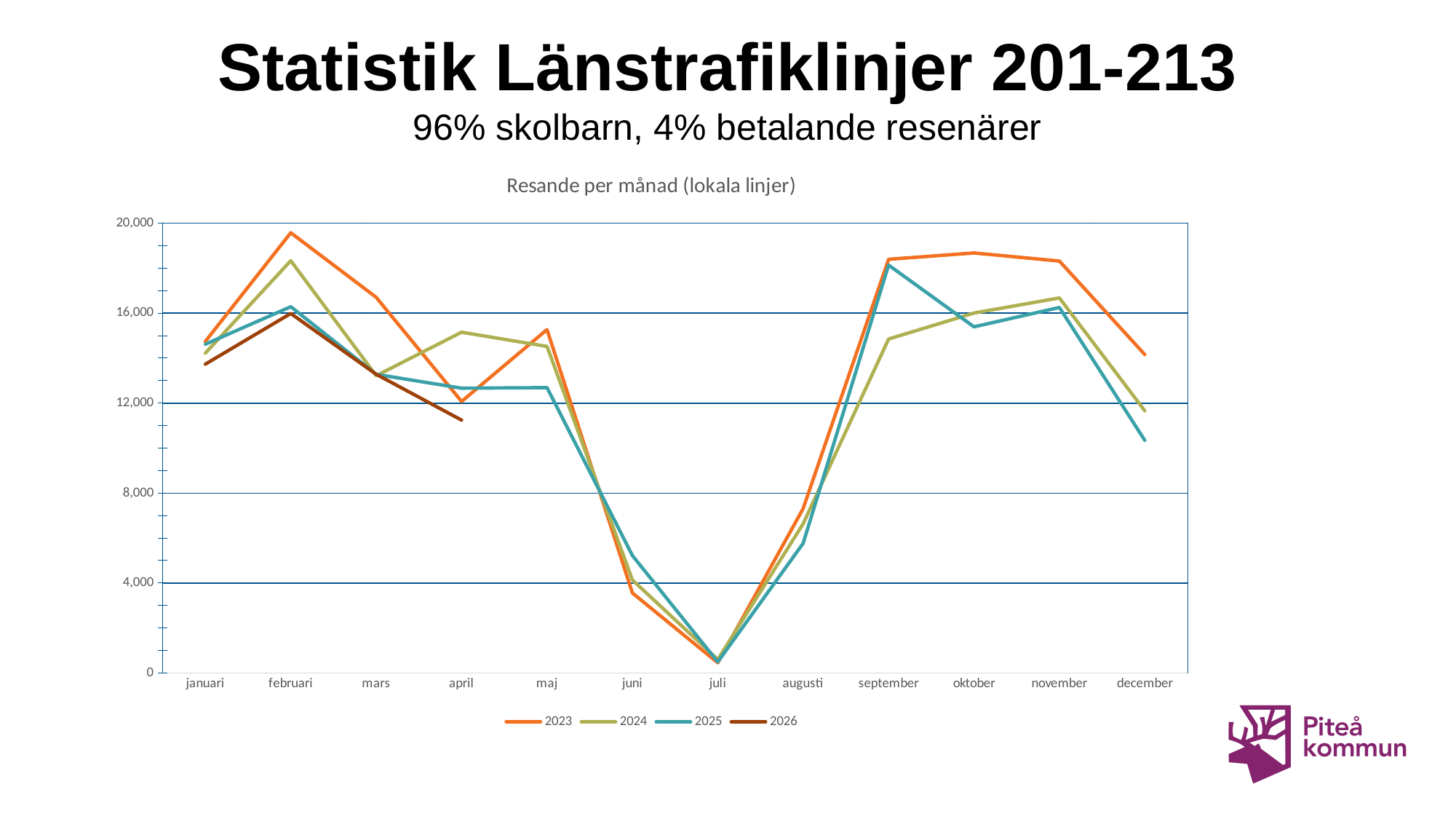
In which month does the 2023 series reach its lowest value? juli What kind of chart is shown on the slide? line chart Is the value for 2026 in april greater or less than 12,000? less What is the title of the chart? Resande per månad (lokala linjer) Is the value for 2025 in juni greater or less than 4,000? greater Does the 2026 series rise or fall from februari to april? fall Is the value for 2023 in februari greater or less than 16,000? greater In which month does the 2023 series reach its highest value? februari How many series does the legend list? 4 How many months are shown along the x axis? 12 Which series has the higher value in december, 2024 or 2025? 2024 Which series has the higher value in september, 2023 or 2024? 2023